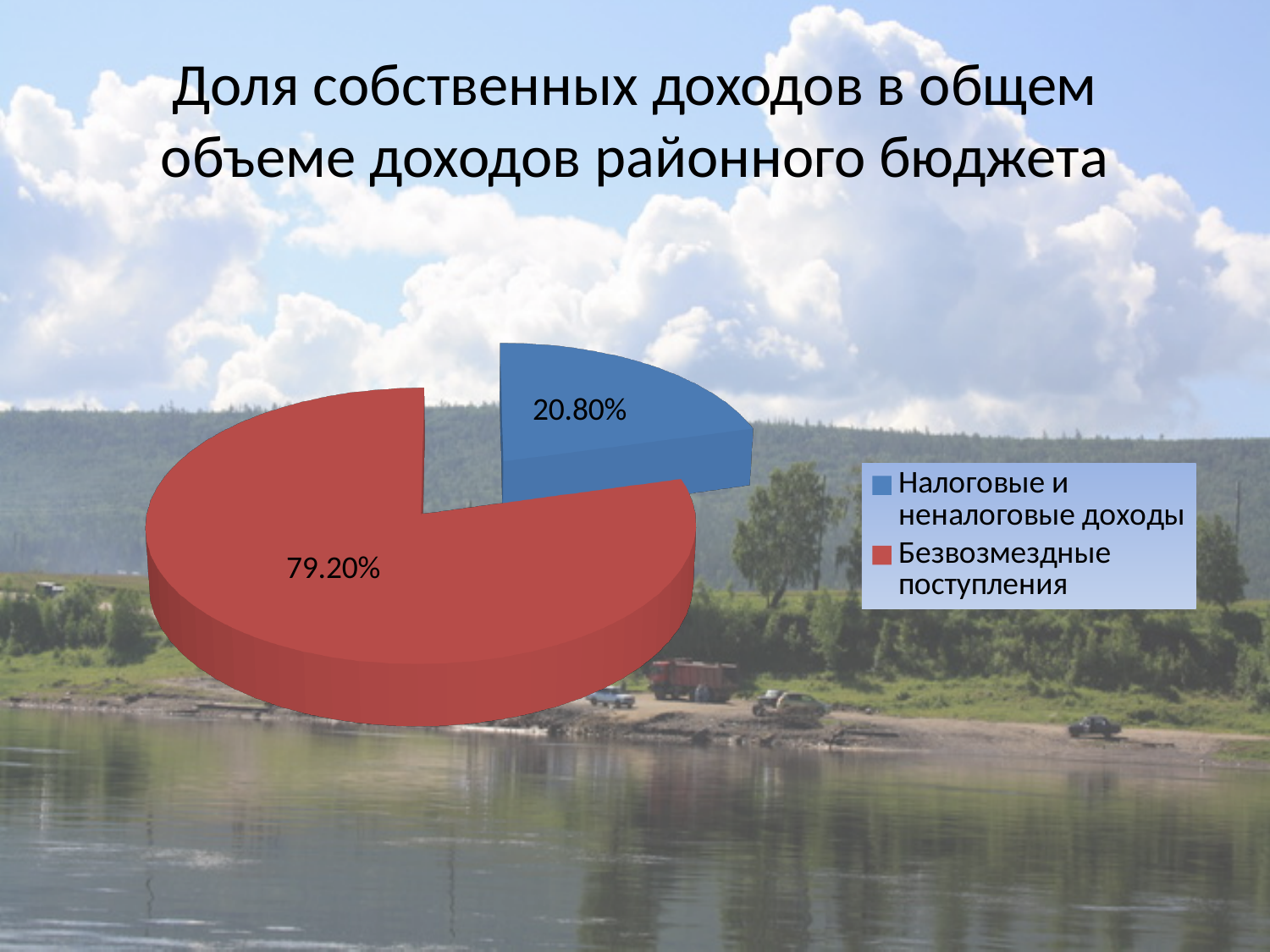
What share of the pie does Налоговые и неналоговые доходы represent? 20.80% How many entries does the legend list? 2 What is the value for Безвозмездные поступления? 79.20% Which is larger: the share of Налоговые и неналоговые доходы or the share of Безвозмездные поступления? Безвозмездные поступления What kind of chart is shown on the slide? Pie chart What is the value for Налоговые и неналоговые доходы? 20.80% What is the difference between the shares of Безвозмездные поступления and Налоговые и неналоговые доходы? 58.40% What colour is the slice for Безвозмездные поступления? Red Which category has the smallest share of the pie? Налоговые и неналоговые доходы What is the title of the chart on the slide? Доля собственных доходов в общем объеме доходов районного бюджета Which category has the largest share of the pie? Безвозмездные поступления How many slices does the pie chart have? 2